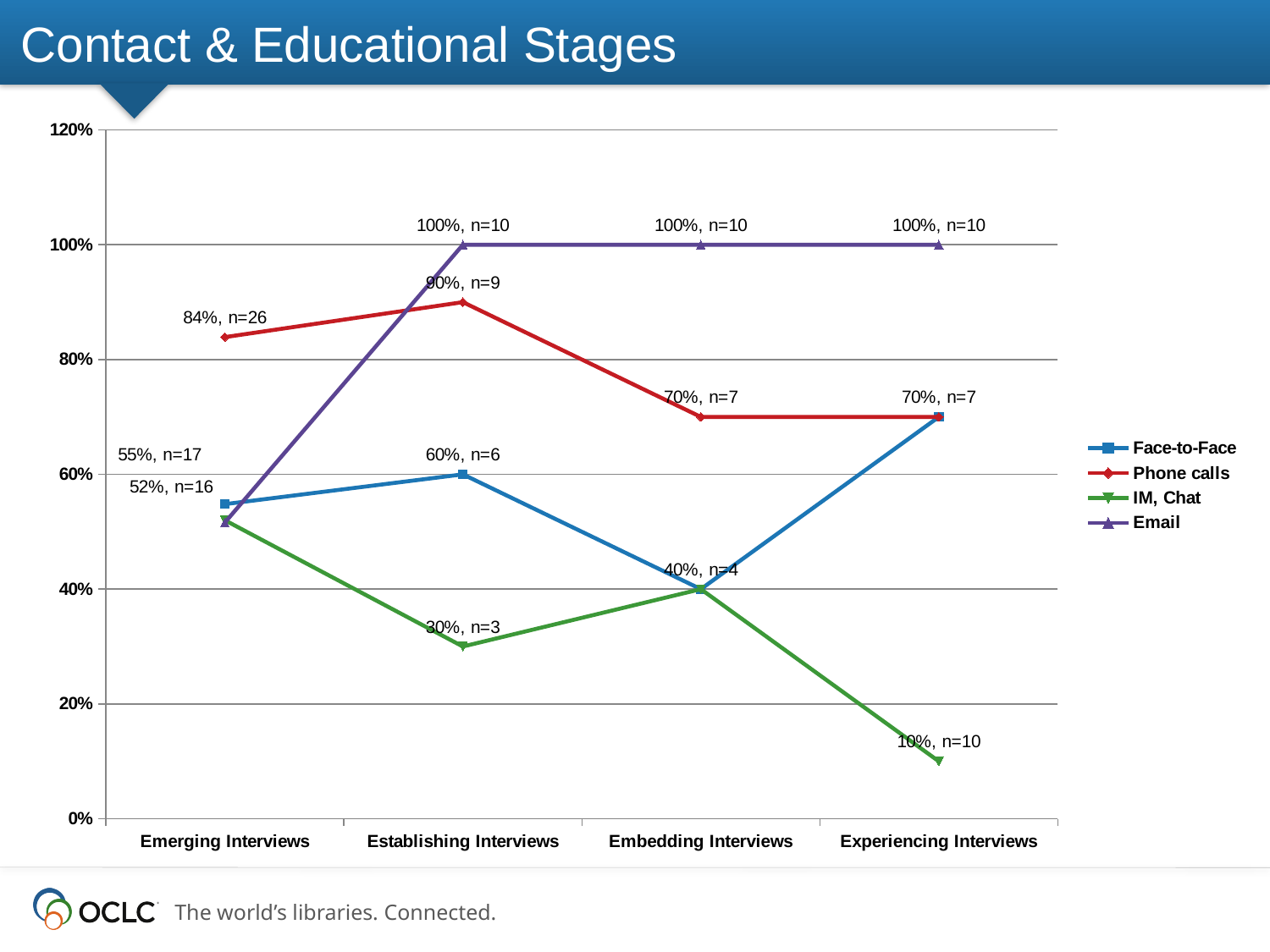
Which series has the lowest value at Experiencing Interviews? IM, Chat How many interview stages are shown along the x axis? 4 What is the value for Face-to-Face at Establishing Interviews? 60% Does the Phone calls line rise or fall from Establishing Interviews to Embedding Interviews? Fall What type of chart is shown on the slide? Line chart What is the value for Email at Embedding Interviews? 100% How many series does the legend list? 4 What is the value for Phone calls at Emerging Interviews? 84% Which series has the highest value at Establishing Interviews? Email What is the difference between the Phone calls values at Establishing Interviews and Embedding Interviews? 20 percentage points What is the value for IM, Chat at Experiencing Interviews? 10% At Emerging Interviews, which is larger: Face-to-Face or Phone calls? Phone calls